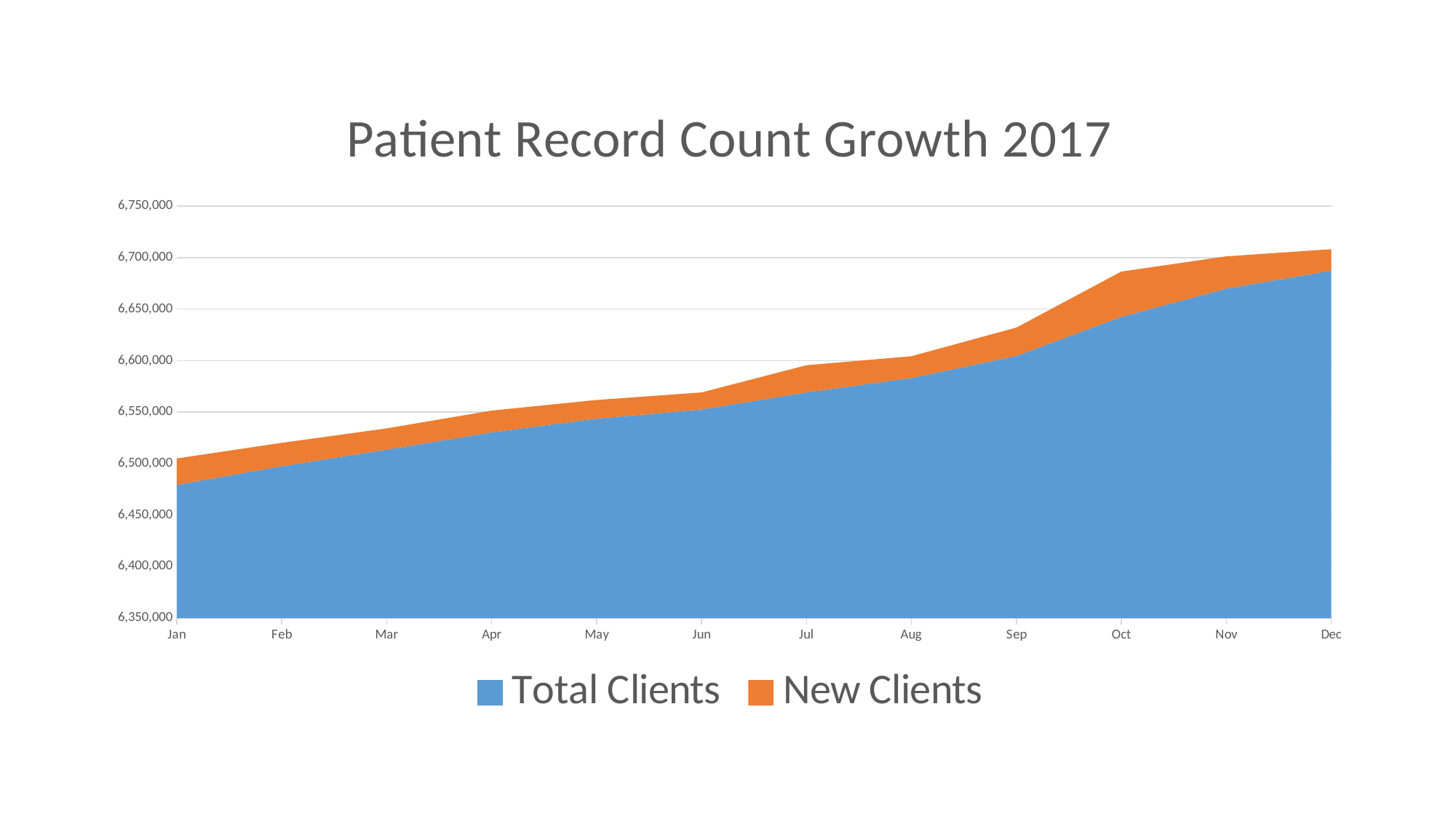
Which colour represents the New Clients series? Orange What kind of chart is shown on the slide? Stacked area chart In which month is the Total Clients value lowest? Jan Which is larger, the Total Clients value for Dec or for Jan? Dec In which month is the Total Clients value highest? Dec Is the Total Clients value for Jan greater or less than 6,500,000? less How many months are plotted along the x axis? 12 What is the title of the chart? Patient Record Count Growth 2017 Is the Total Clients value for Aug greater or less than 6,600,000? less Does the Total Clients series rise or fall from Jan to Dec? Rise How many series does the legend list? 2 Is the Total Clients value for Dec greater or less than 6,650,000? greater